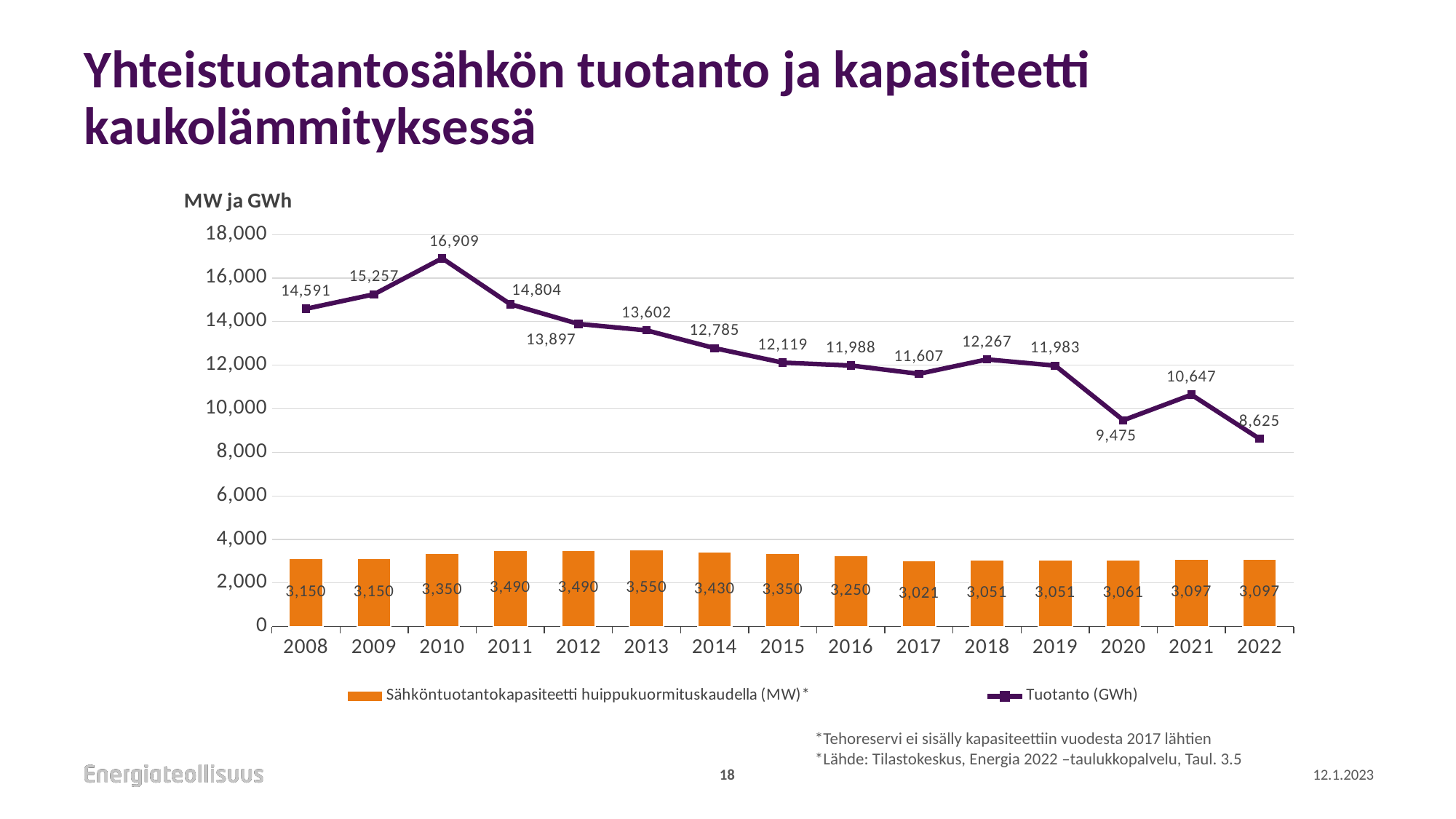
In which year was Tuotanto (GWh) highest? 2010 What is the difference between the Tuotanto (GWh) values for 2021 and 2020? 1,172 Does the Tuotanto (GWh) line generally rise or fall from 2010 to 2022? Fall What was the Tuotanto (GWh) value in 2010? 16,909 In which year was Tuotanto (GWh) lowest? 2022 What was the Tuotanto (GWh) value in 2022? 8,625 How many series does the legend list? 2 What kind of chart is shown on the slide? Combined bar and line chart In which year was the Sähköntuotantokapasiteetti (MW) bar lowest? 2017 What was the Sähköntuotantokapasiteetti huippukuormituskaudella (MW) value in 2013? 3,550 How many years are shown on the x axis? 15 Which year had a higher Tuotanto (GWh) value, 2018 or 2019? 2018